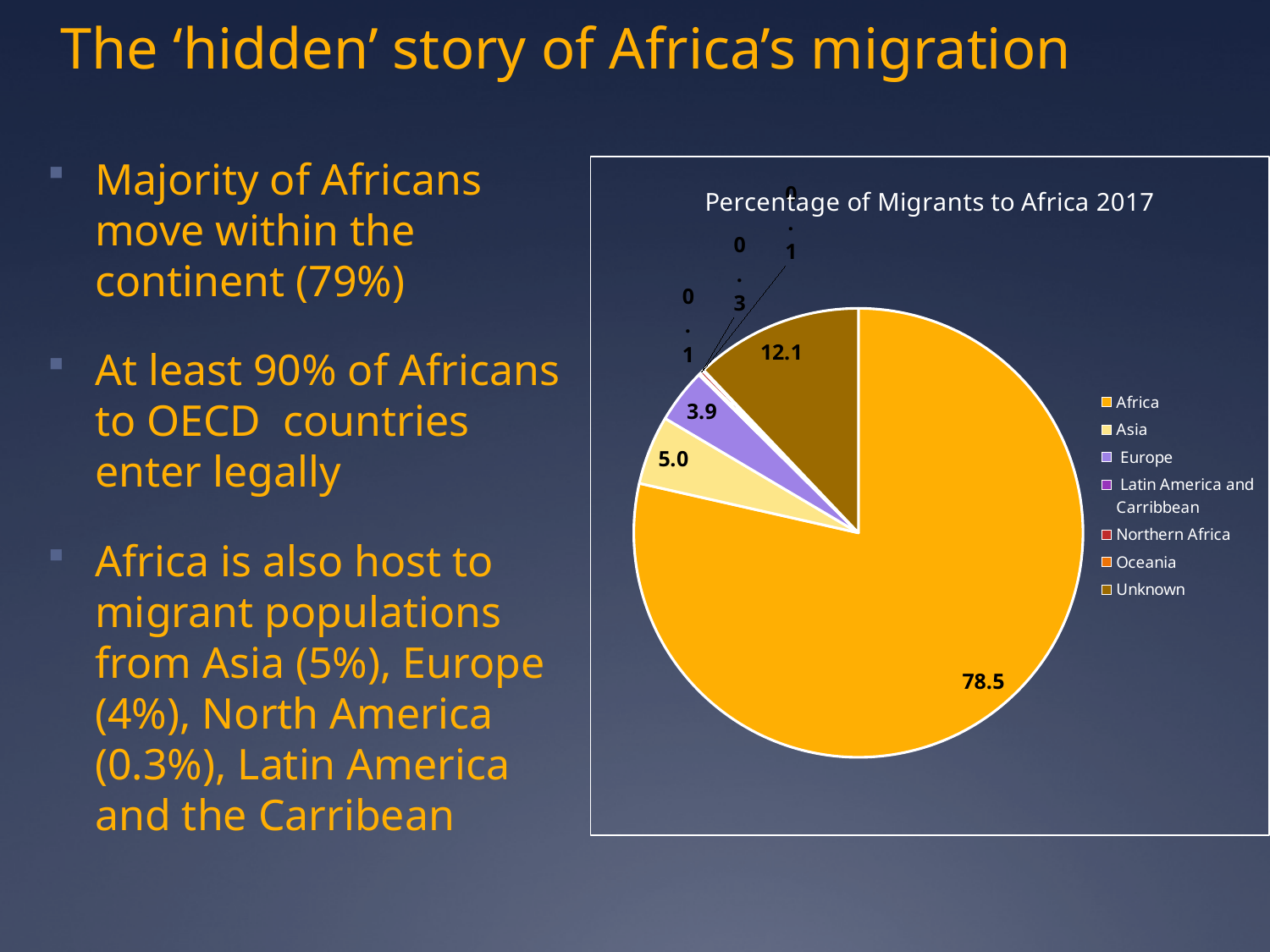
What is the value for Asia in the pie chart? 5.0 What is the difference between the values for Africa and Unknown? 66.4 Which is larger, the value for Unknown or the value for Asia? Unknown What is the difference between the values for Asia and Europe? 1.1 What kind of chart is shown on the slide? pie chart What is the value for Europe in the pie chart? 3.9 Which category has the largest slice of the pie? Africa What is the value for Unknown in the pie chart? 12.1 Which is larger, the value for Asia or the value for Europe? Asia What is the title of the chart? Percentage of Migrants to Africa 2017 How many categories does the legend list? 7 What is the value for Africa in the pie chart? 78.5